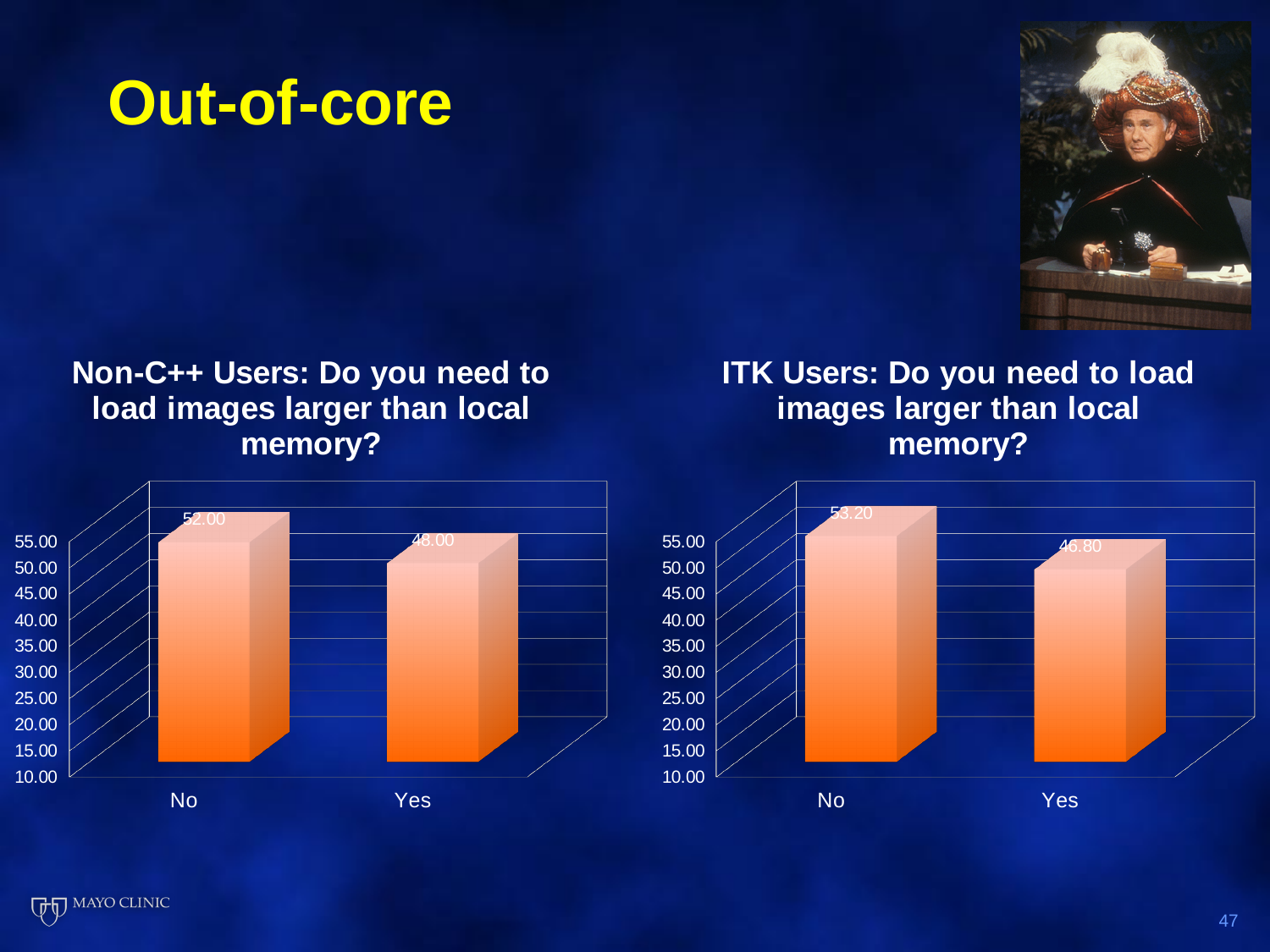
In the 'Non-C++ Users' chart, what is the difference between the No and Yes values? 4.00 In the 'ITK Users' chart, which category has the lower value? Yes In the 'ITK Users' chart, what is the value for No? 53.20 In the 'ITK Users' chart, what is the value for Yes? 46.80 In the 'ITK Users' chart, what is the difference between the No and Yes values? 6.40 In the 'ITK Users' chart, is the value for Yes greater or less than 50.00? less What kind of chart is the 'ITK Users' chart? Bar chart In the 'Non-C++ Users' chart, what is the value for No? 52.00 In the 'Non-C++ Users' chart, which category has the higher value? No How many categories does the 'Non-C++ Users' chart show? 2 Is the value for No in the 'ITK Users' chart larger than the value for No in the 'Non-C++ Users' chart? Yes In the 'Non-C++ Users' chart, what is the value for Yes? 48.00